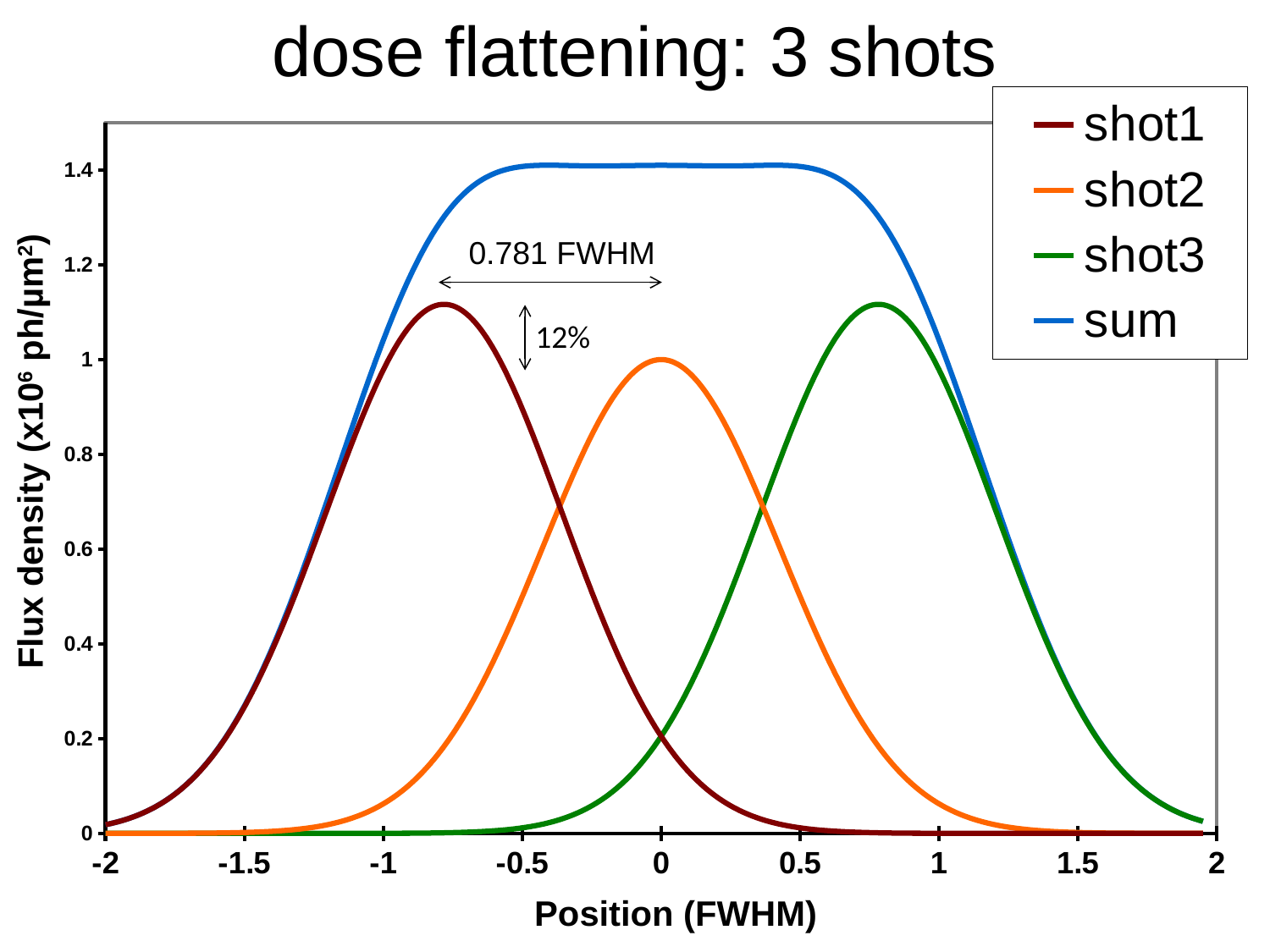
Which series reaches the highest flux density? sum What kind of chart is shown on the slide? line chart What spacing between the shot peaks is annotated on the chart? 0.781 FWHM Is the value of shot2 at position 1 greater or less than 0.2? less Is the value of shot3 at position 0 greater or less than 0.4? less At position 0, which series has the higher value, shot1 or shot2? shot2 At position -1, which series has the higher value, shot1 or shot2? shot1 Is the peak value of shot1 greater or less than 1.2? less What is the label of the x axis? Position (FWHM) How many series does the legend list? 4 What is the title of the chart? dose flattening: 3 shots